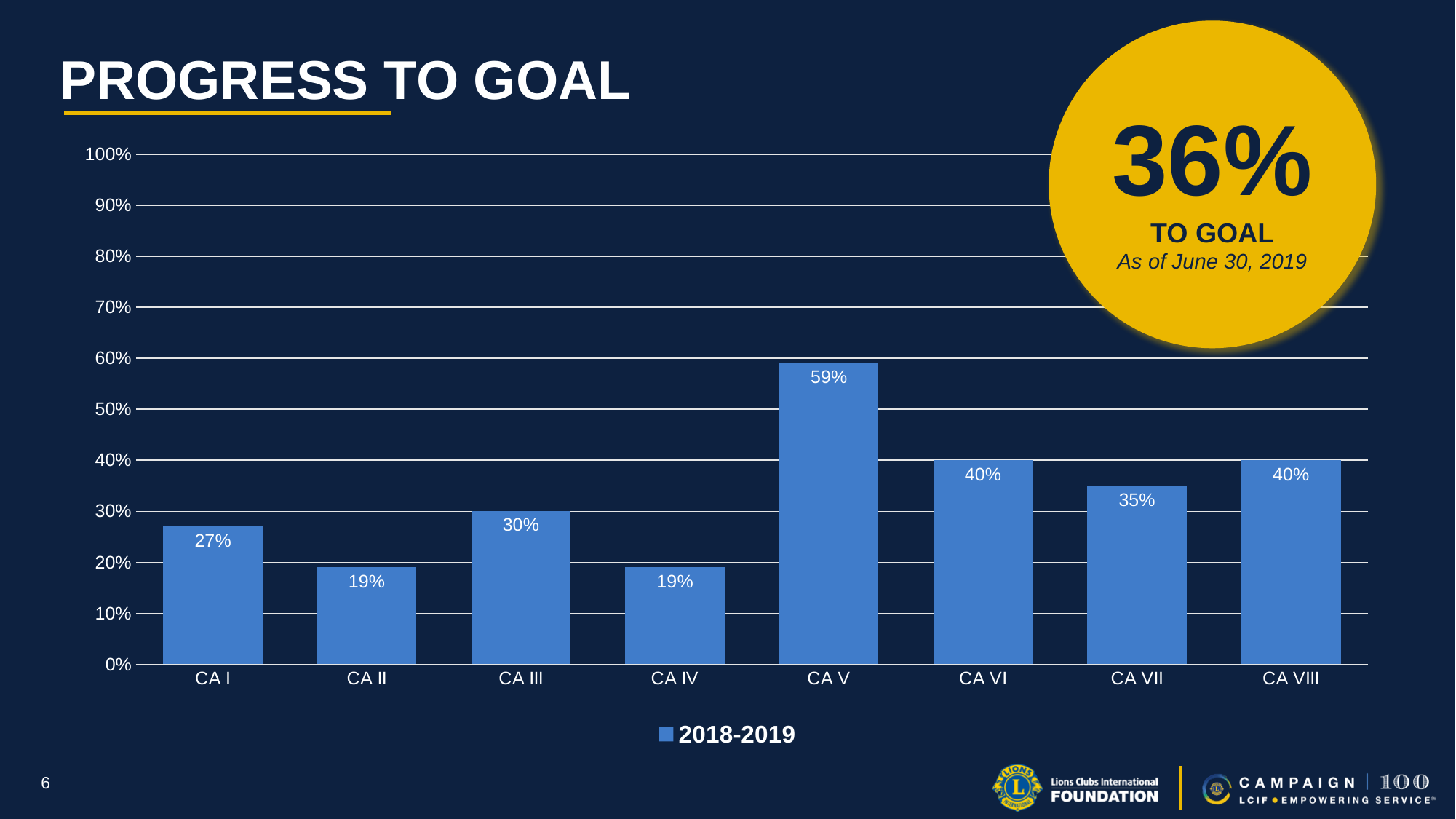
How many categories are shown on the x axis? 8 What is the difference between the values for CA V and CA III? 29% Is the value for CA III greater or less than 20%? greater What is the title of the slide? PROGRESS TO GOAL How many series does the legend list? 1 What kind of chart is shown on the slide? bar chart What is the value for CA V? 59% Which category has the highest value? CA V What is the value for CA I? 27% What series name is shown in the legend? 2018-2019 What is the value for CA VII? 35% Which is larger, the value for CA VI or the value for CA VII? CA VI